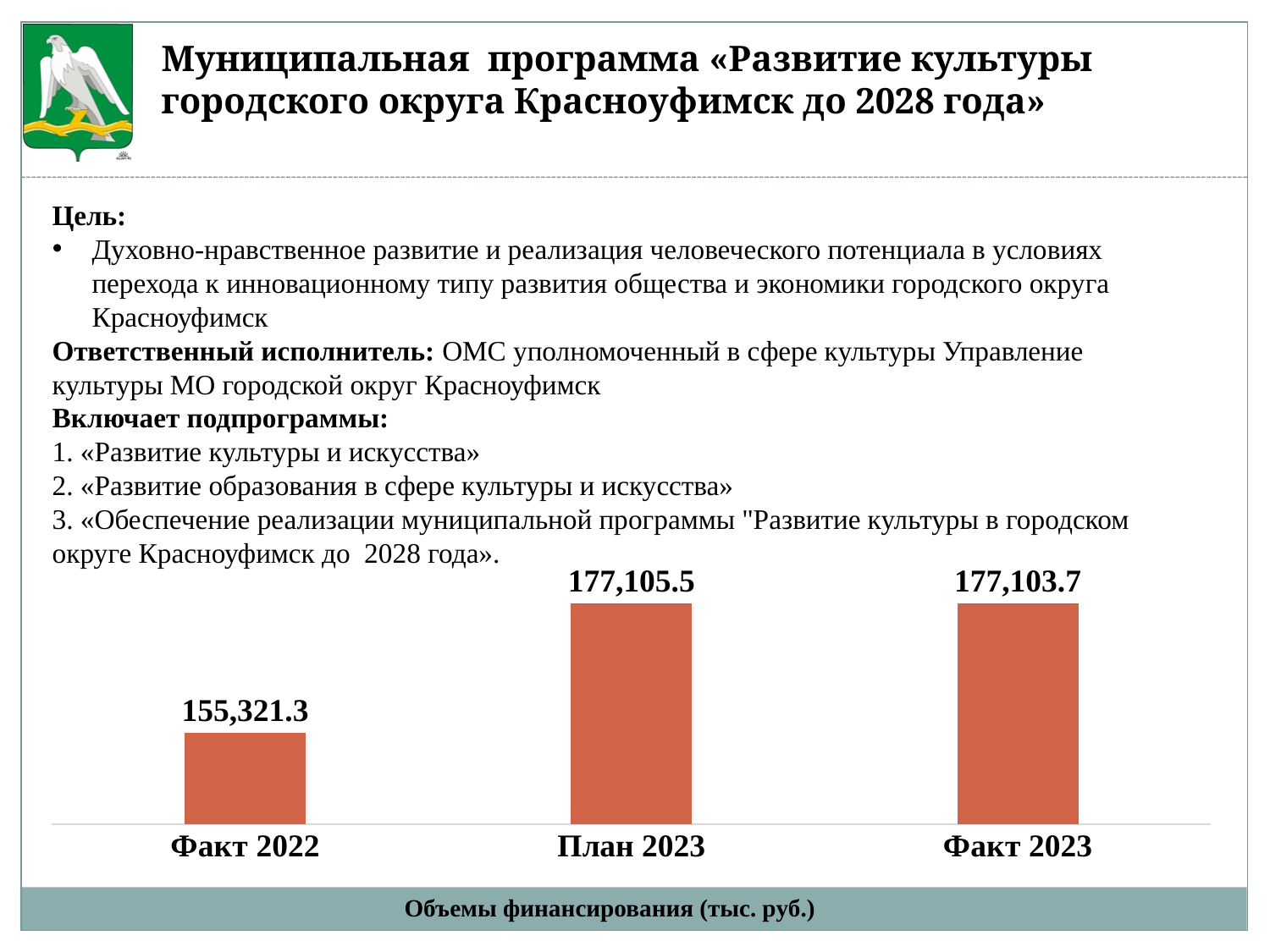
What is the value for План 2023? 177,105.5 Which category has the lowest value? Факт 2022 What is the title of the chart? Объемы финансирования (тыс. руб.) What is the value for Факт 2023? 177,103.7 Does the value rise or fall from Факт 2022 to Факт 2023? Rise What kind of chart is shown on the slide? Bar chart What is the difference between the values for План 2023 and Факт 2023? 1.8 What is the value for Факт 2022? 155,321.3 What is the difference between the values for Факт 2023 and Факт 2022? 21,782.4 Which is larger, the value for Факт 2022 or the value for План 2023? План 2023 What is the difference between the values for План 2023 and Факт 2022? 21,784.2 How many categories are shown in the chart? 3